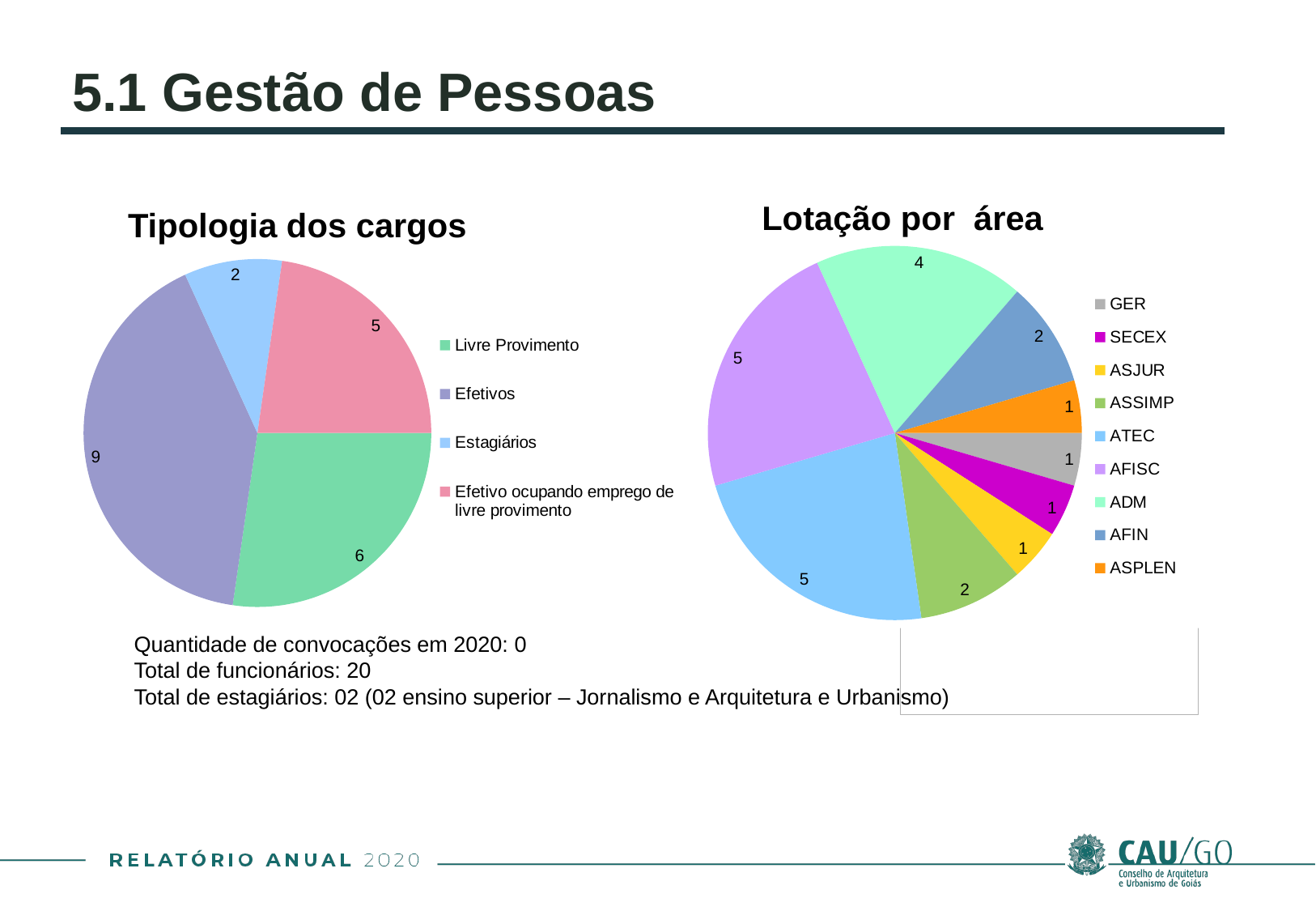
In the 'Lotação por área' chart, what is the value for ATEC? 5 In the 'Lotação por área' chart, how many areas does the legend list? 9 In the 'Tipologia dos cargos' chart, which category has the largest slice? Efetivos In the 'Tipologia dos cargos' chart, which category has the smallest slice? Estagiários In the 'Lotação por área' chart, what is the value for ASSIMP? 2 In the 'Tipologia dos cargos' chart, what is the value for Efetivos? 9 In the 'Tipologia dos cargos' chart, how many categories are shown? 4 In the 'Lotação por área' chart, which is larger, AFISC or AFIN? AFISC In the 'Tipologia dos cargos' chart, what is the difference between Efetivos and Estagiários? 7 What type of chart is 'Lotação por área'? Pie chart In the 'Tipologia dos cargos' chart, what is the value for Livre Provimento? 6 In the 'Lotação por área' chart, what is the value for ADM? 4